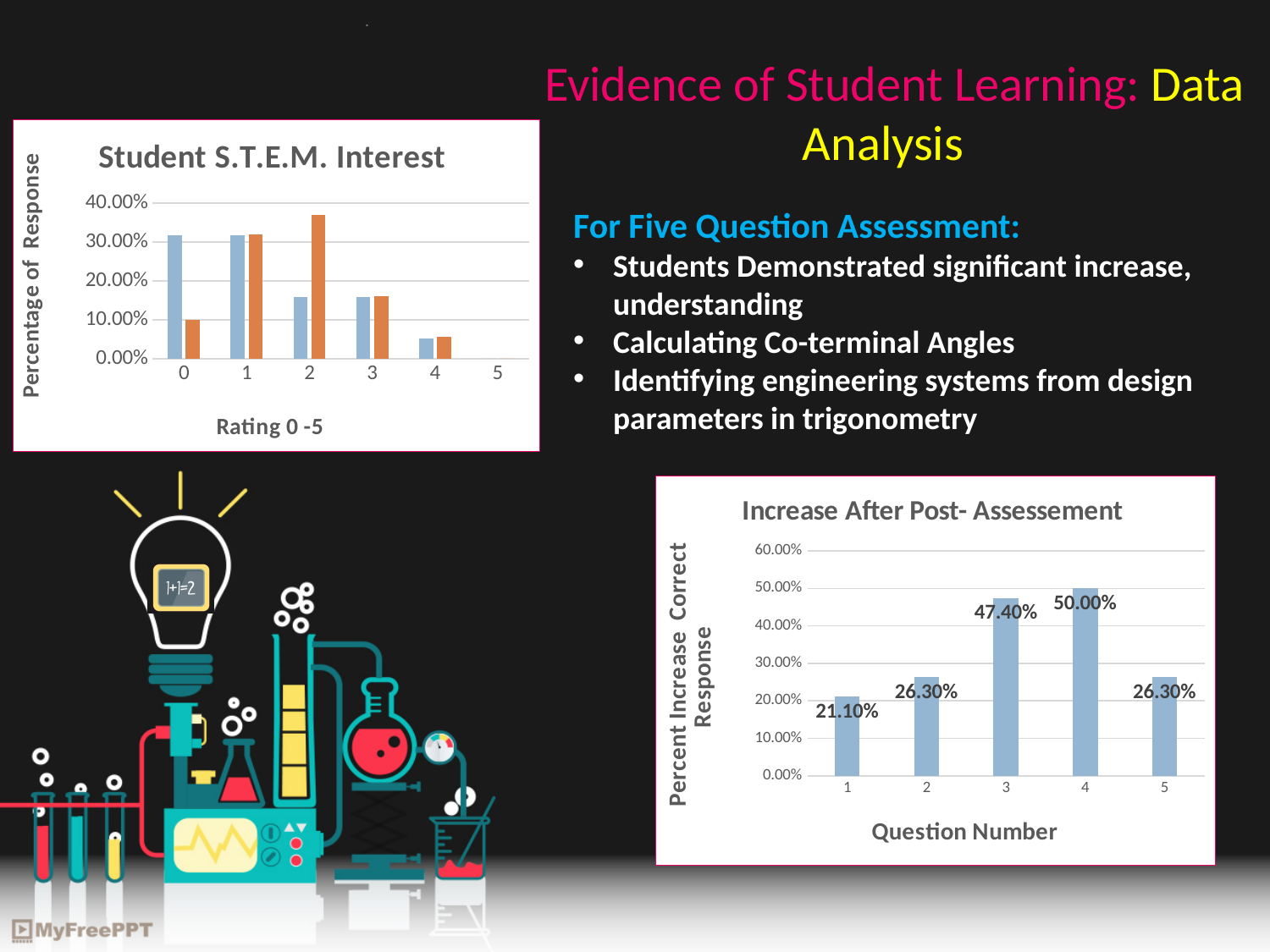
In the 'Student S.T.E.M. Interest' chart, which rating has the tallest orange bar? 2 In the 'Student S.T.E.M. Interest' chart, is the orange bar for rating 2 greater or less than 30.00%? greater In the 'Increase After Post- Assessement' chart, how many question numbers are shown on the x axis? 5 In the 'Increase After Post- Assessement' chart, which question number has the lowest value? 1 In the 'Increase After Post- Assessement' chart, what is the value for question number 3? 47.40% In the 'Increase After Post- Assessement' chart, which question number has the highest value? 4 What kind of chart is 'Increase After Post- Assessement'? Bar chart In the 'Student S.T.E.M. Interest' chart, is the blue bar for rating 4 greater or less than 10.00%? less In the 'Increase After Post- Assessement' chart, which is larger: the value for question 2 or question 3? Question 3 What is the x-axis title of the 'Student S.T.E.M. Interest' chart? Rating 0 -5 In the 'Increase After Post- Assessement' chart, what is the value for question number 1? 21.10% In the 'Increase After Post- Assessement' chart, what is the difference between the values for question 4 and question 1? 28.90%